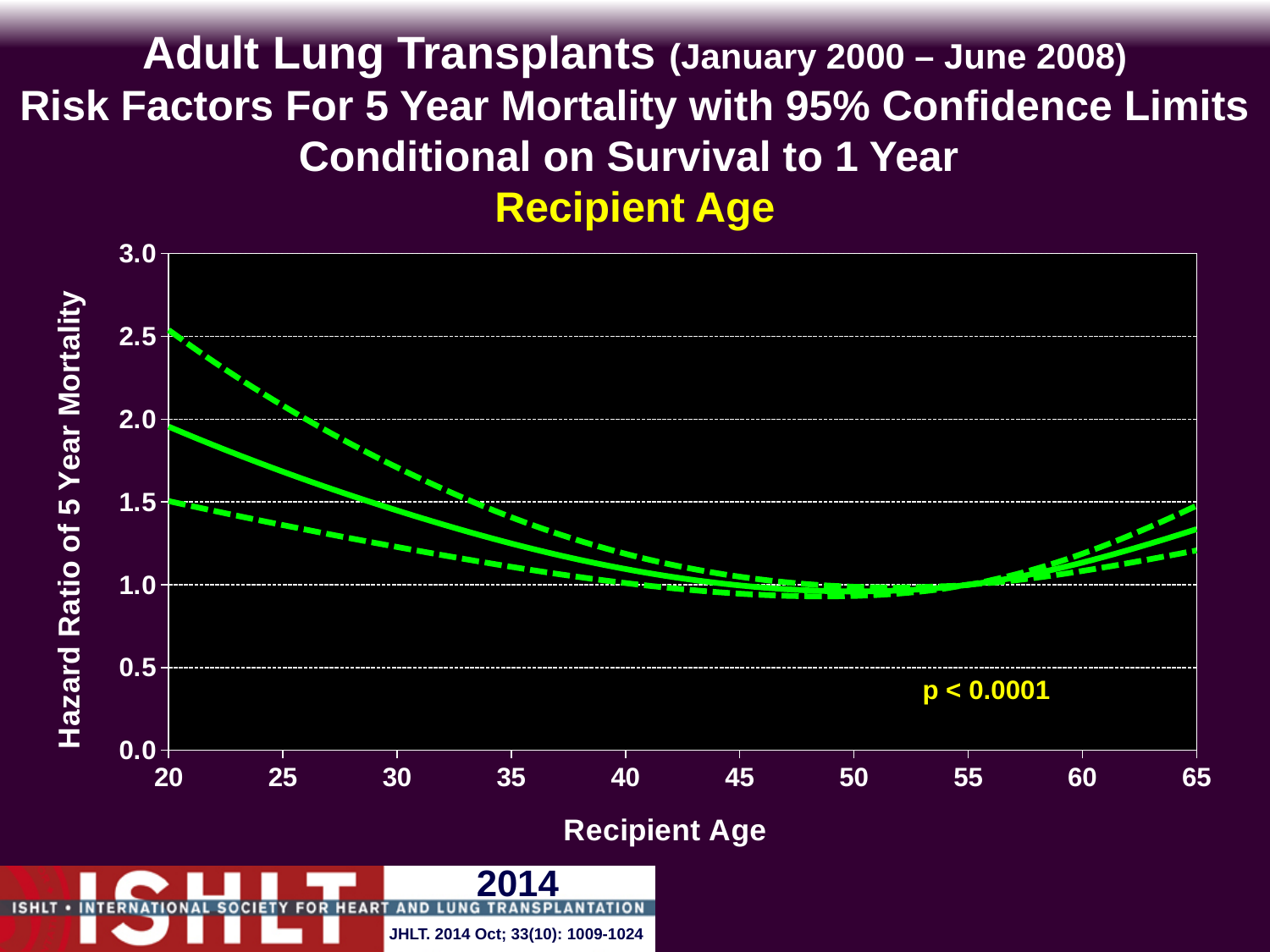
At which recipient age shown on the x axis is the solid hazard ratio line highest, 20 or 65? 20 What is the title of the y axis? Hazard Ratio of 5 Year Mortality What p-value is printed on the chart? p < 0.0001 Is the solid hazard ratio line at recipient age 20 greater or less than 1.5? greater Is the solid hazard ratio line at recipient age 65 greater or less than 1.0? greater How many lines are plotted on the chart? 3 What is the title of the x axis? Recipient Age Does the solid hazard ratio line rise or fall as recipient age increases from 20 to 45? fall Is the upper dashed confidence limit at recipient age 20 greater or less than 2.0? greater Does the solid hazard ratio line rise or fall as recipient age increases from 55 to 65? rise What kind of chart is shown on the slide? line chart